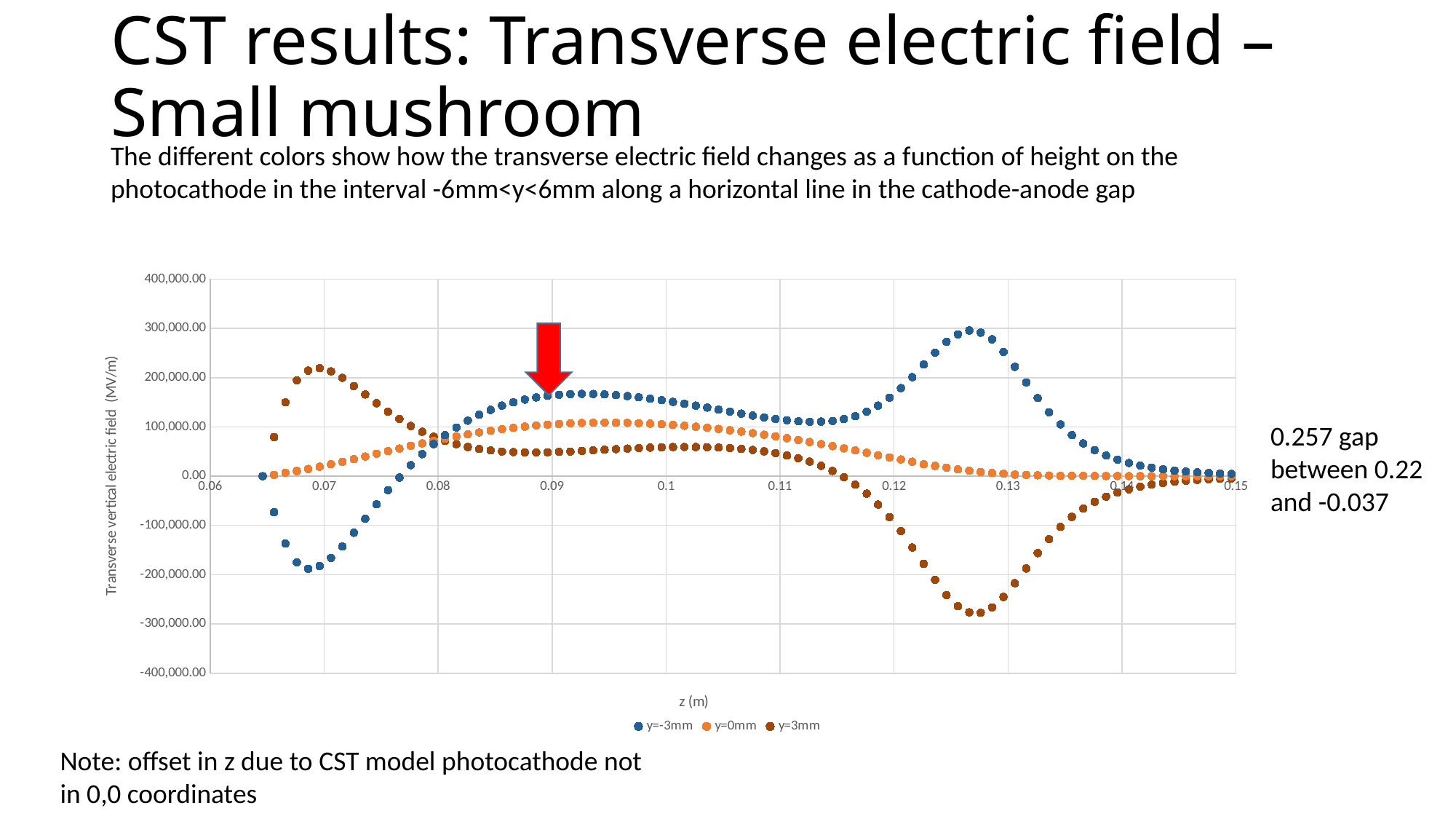
Which series reaches the highest value on the chart? y=-3mm What are the three series named in the legend? y=-3mm, y=0mm, y=3mm At z=0.09, which series has the larger value, y=-3mm or y=0mm? y=-3mm How many series does the legend list? 3 At z=0.13, which series has the larger value, y=-3mm or y=3mm? y=-3mm What is the title of the x axis? z (m) Is the peak value of the y=-3mm series near z=0.13 greater or less than 200,000.00? greater Is the minimum value of the y=3mm series near z=0.13 greater or less than -200,000.00? less Is the value of the y=-3mm series at z=0.07 greater or less than -100,000.00? less Which series reaches the lowest value on the chart? y=3mm What kind of chart is shown on the slide? Scatter chart